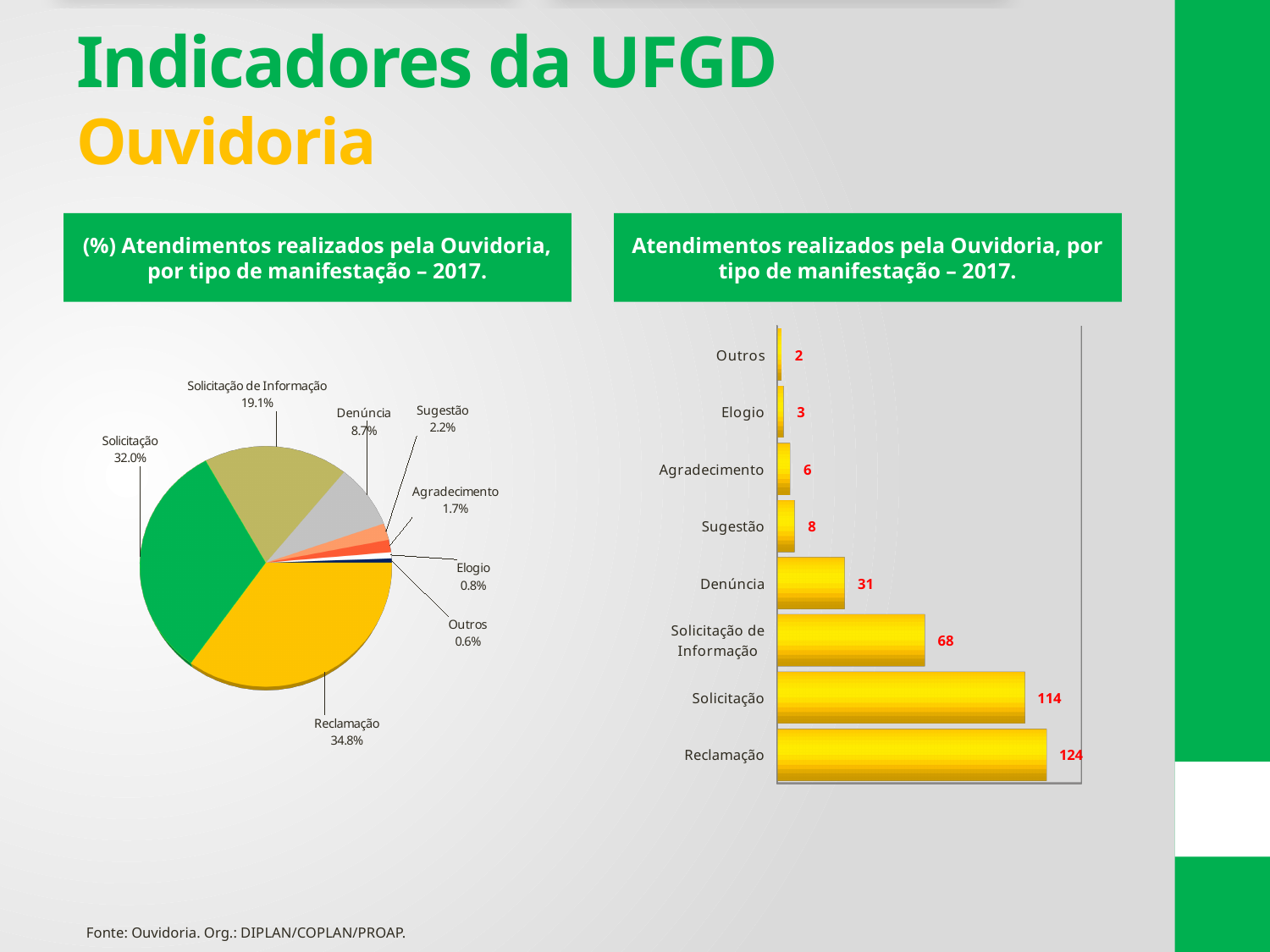
In the bar chart on the right, what is the value for Denúncia? 31 In the bar chart on the right, which category has the highest value? Reclamação In the pie chart on the left, what share does Solicitação have? 32.0% In the bar chart on the right, which category has the lowest value? Outros How many categories are shown in the bar chart on the right? 8 In the pie chart on the left, what percentage is shown for Agradecimento? 1.7% In the bar chart on the right, what is the difference between Solicitação and Solicitação de Informação? 46 In the bar chart on the right, which is larger: Sugestão or Agradecimento? Sugestão What type of chart is the chart on the right? Bar chart What type of chart is the chart on the left? Pie chart In the pie chart on the left, which slice is the largest? Reclamação In the bar chart on the right, what is the value for Reclamação? 124